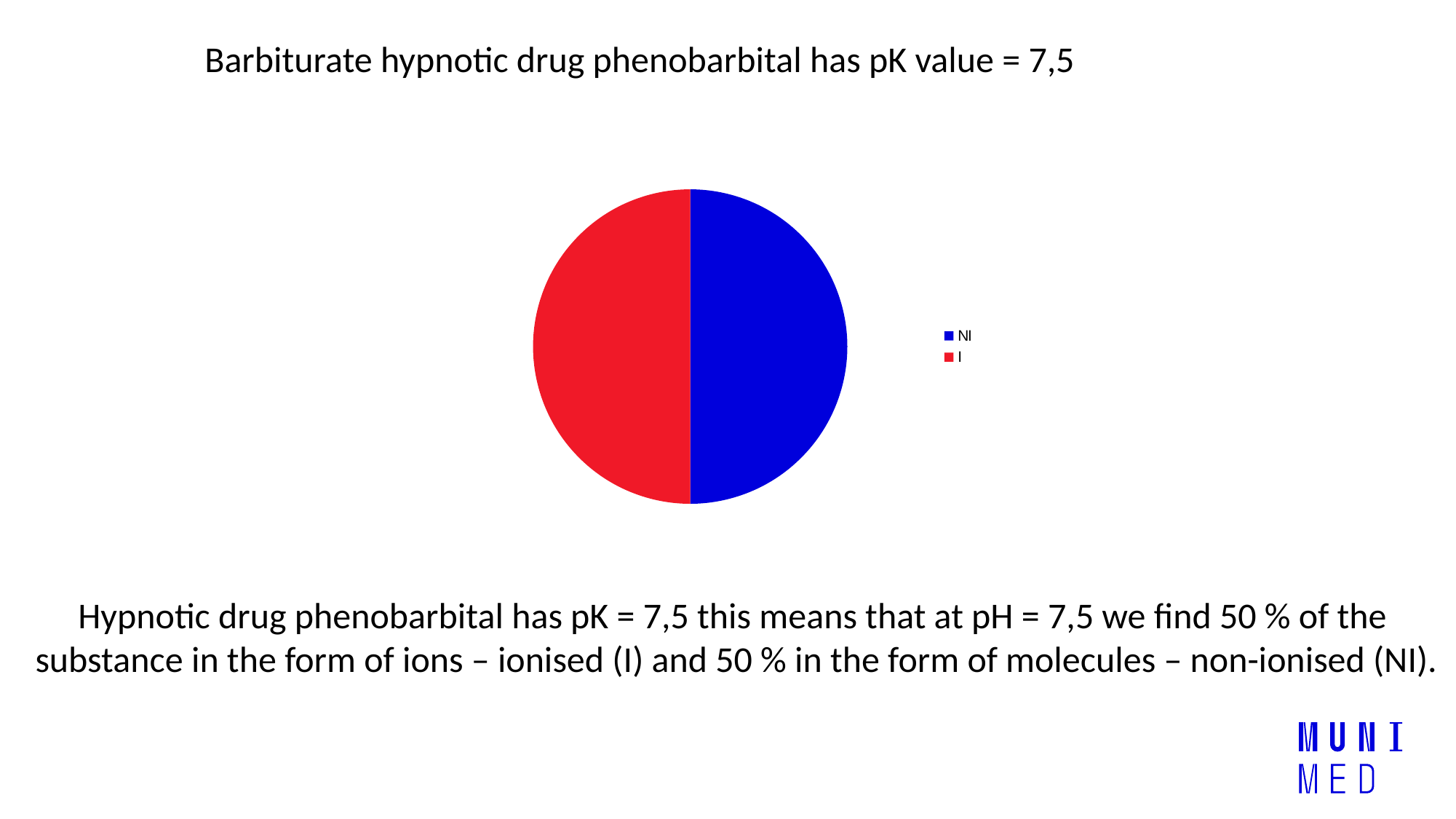
What share of the pie chart does the NI slice represent? 50 % Which colour represents I in the pie chart? red What share of the pie chart does the I slice represent? 50 % How many entries does the legend of the pie chart list? 2 Which colour represents NI in the pie chart? blue What kind of chart is shown on the slide? pie chart How many slices does the pie chart have? 2